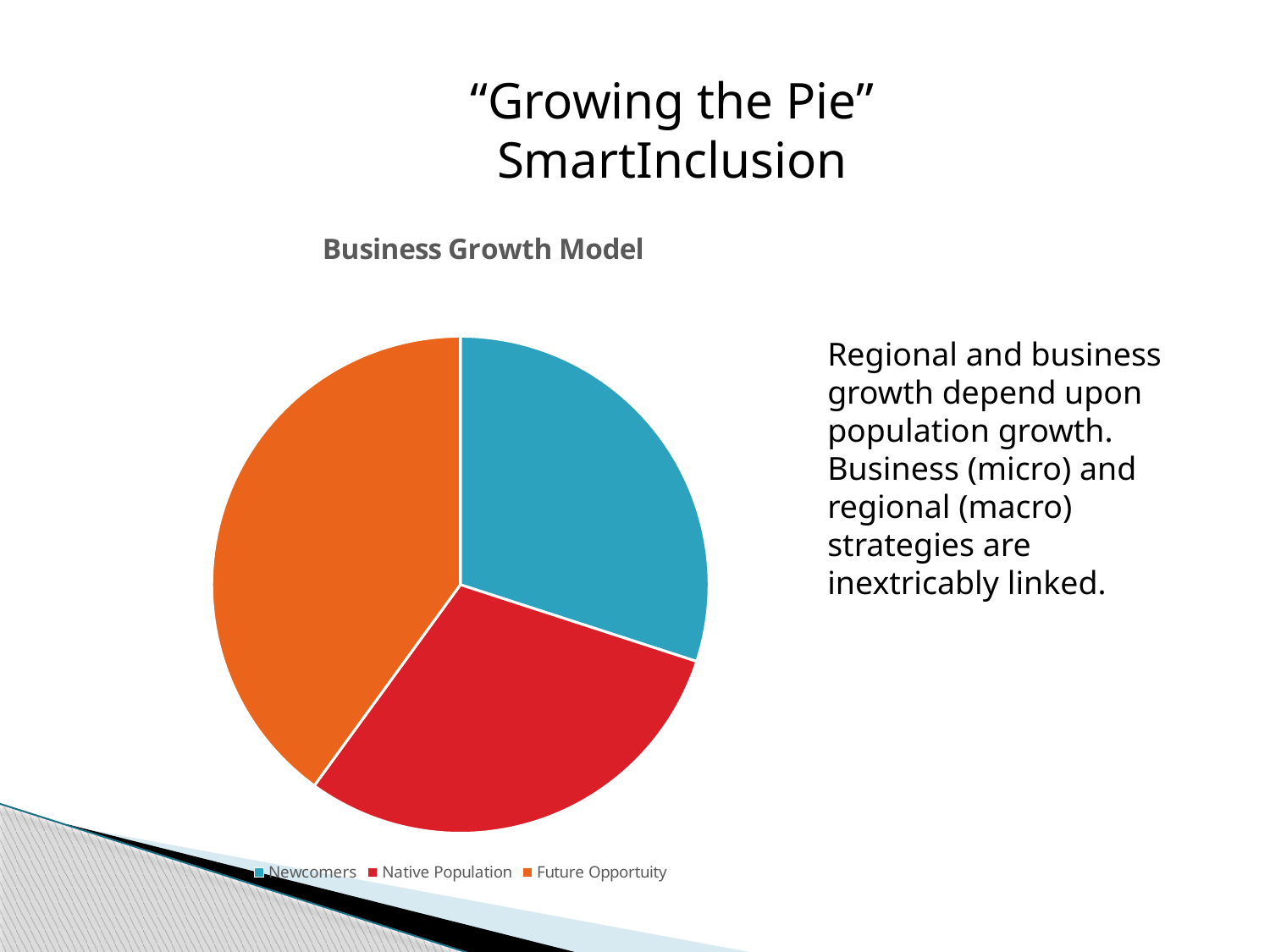
What kind of chart is shown on the slide? pie chart Which category is shown in orange in the pie chart? Future Opportunity Which category has the largest slice of the pie? Future Opportunity How many entries does the chart's legend list? 3 How many slices does the pie chart have? 3 Which slice is larger, Future Opportunity or Native Population? Future Opportunity Which slice is larger, Future Opportunity or Newcomers? Future Opportunity What is the title of the chart? Business Growth Model